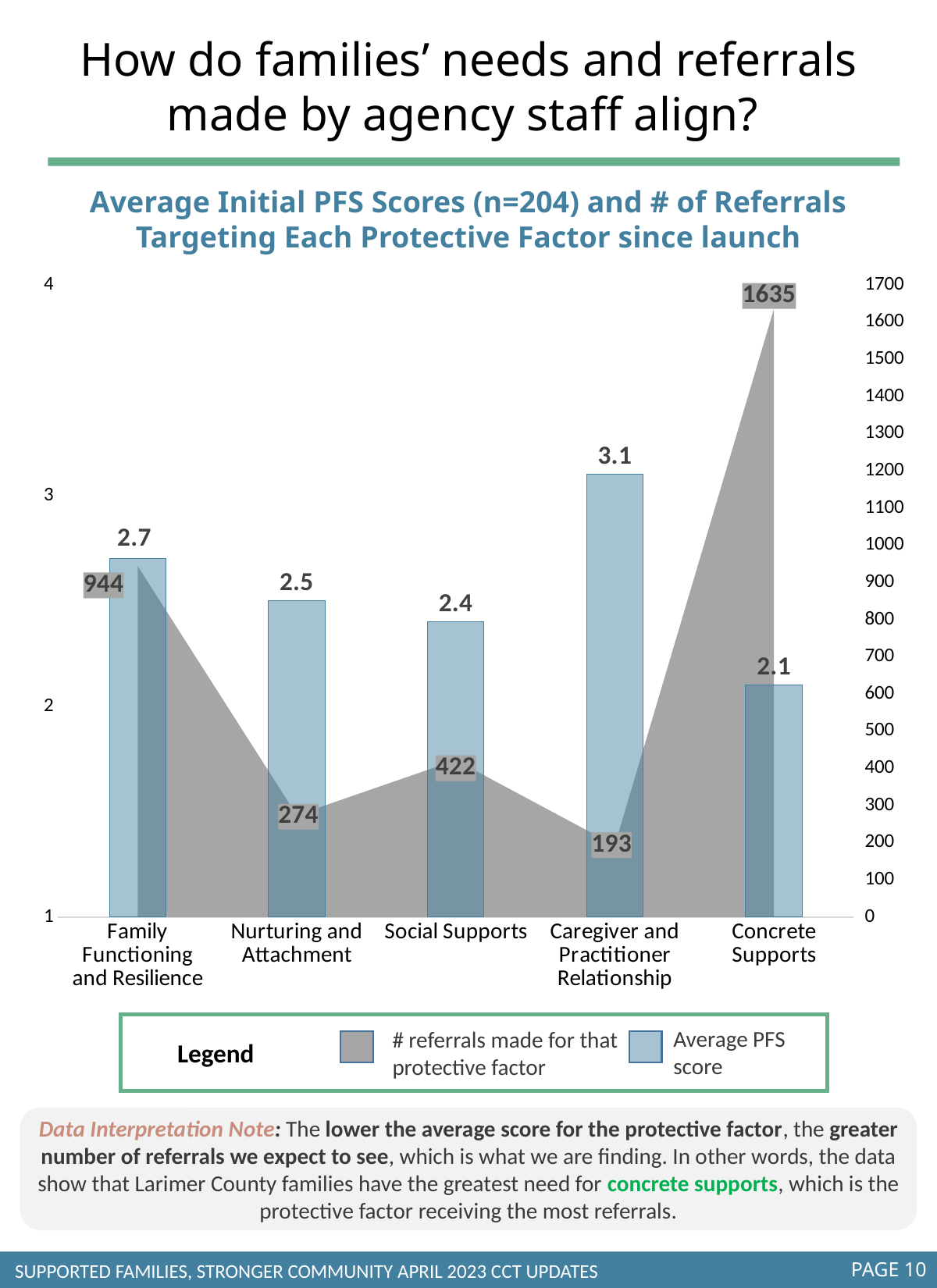
Which received more referrals, Social Supports or Nurturing and Attachment? Social Supports How many referrals were made for Nurturing and Attachment? 274 How many series does the legend list? 2 What is the difference between the average PFS scores for Nurturing and Attachment and Social Supports? 0.1 How many referrals were made for Concrete Supports? 1635 What is the difference in number of referrals between Family Functioning and Resilience and Social Supports? 522 What does the grey shaded area represent according to the legend? # referrals made for that protective factor How many protective factors are shown on the x axis? 5 Which protective factor received the fewest referrals? Caregiver and Practitioner Relationship What is the average PFS score for Caregiver and Practitioner Relationship? 3.1 Which protective factor has the lowest average PFS score? Concrete Supports Which protective factor has the highest average PFS score? Caregiver and Practitioner Relationship